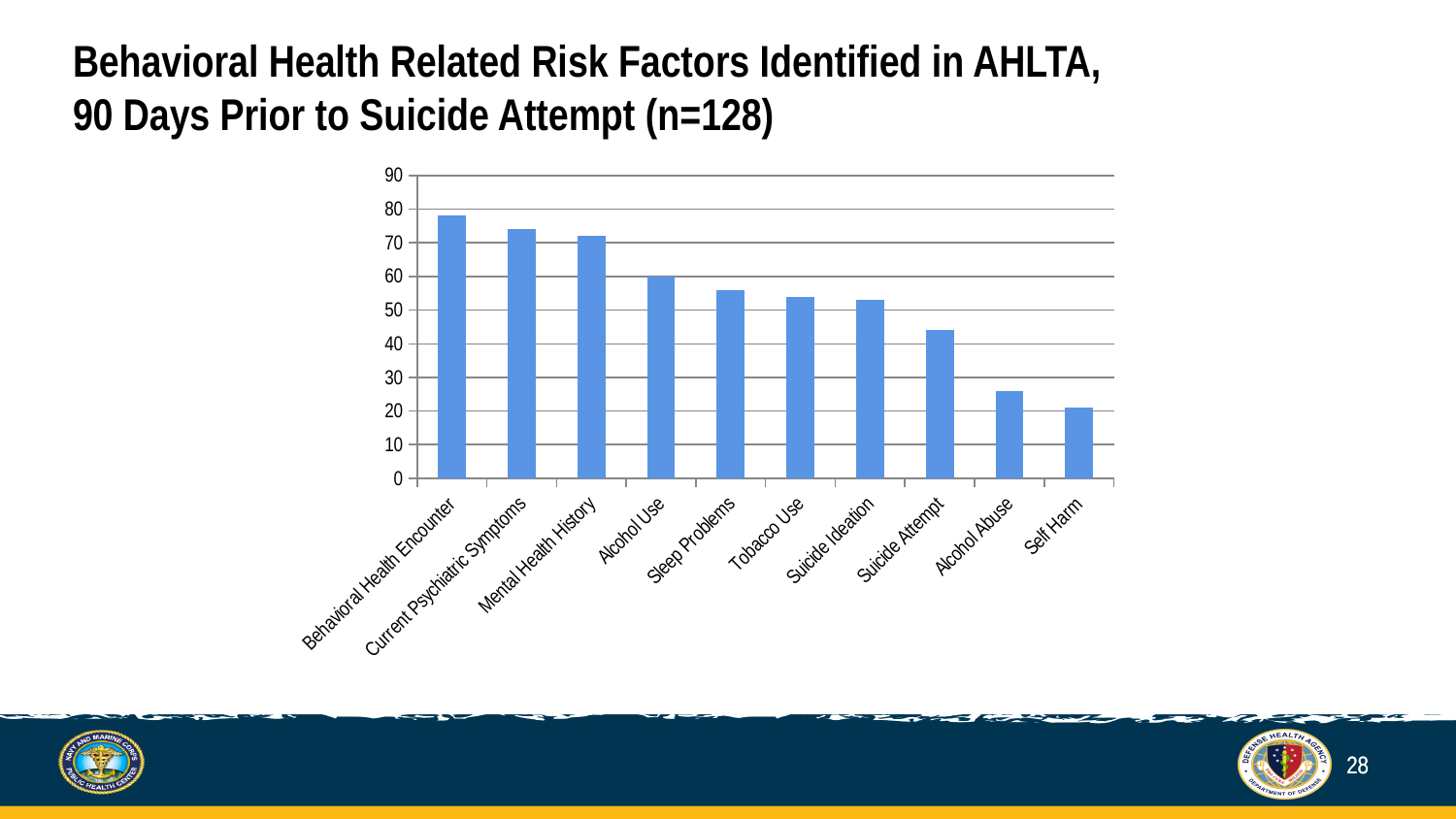
Is the value for Behavioral Health Encounter greater or less than 70? greater What is the sample size (n) stated in the slide title? 128 What kind of chart is shown on the slide? bar chart Is the value for Suicide Attempt greater or less than 40? greater Which risk factor has the lowest value in the chart? Self Harm Is the value for Self Harm greater or less than 30? less Which risk factor has the highest value in the chart? Behavioral Health Encounter How many risk factor categories are plotted in the chart? 10 Do the bar values rise or fall from left to right across the categories? fall Which is larger, the value for Mental Health History or the value for Alcohol Use? Mental Health History Which is larger, the value for Suicide Attempt or the value for Alcohol Abuse? Suicide Attempt